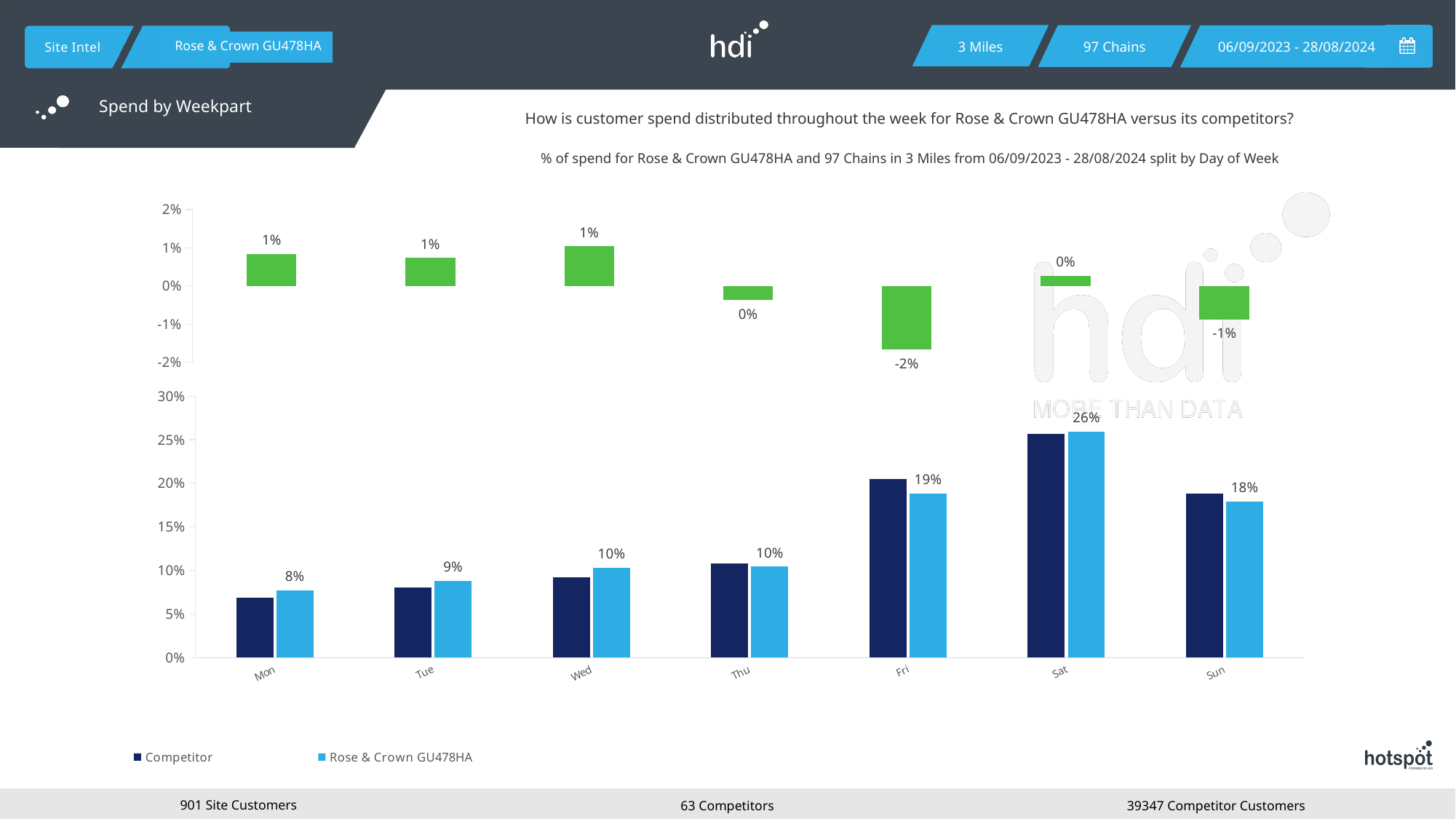
In the bottom bar chart, which day has the lowest Rose & Crown GU478HA value? Mon In the bottom bar chart, is the Competitor value for Mon greater or less than 10%? less How many days are shown on the x axis of the bottom bar chart? 7 In the bottom bar chart, which day has the highest Rose & Crown GU478HA value? Sat In the top chart with green bars, what is the value for Fri? -2% In the bottom bar chart, what is the difference between the Rose & Crown GU478HA values for Sat and Sun? 8% In the bottom bar chart, what is the value for Rose & Crown GU478HA on Fri? 19% In the top chart with green bars, which day has the lowest value? Fri In the bottom bar chart, is the Competitor value for Sat greater or less than 20%? greater In the bottom bar chart, what is the value for Rose & Crown GU478HA on Mon? 8% In the bottom bar chart, what is the value for Rose & Crown GU478HA on Sat? 26% How many series does the legend of the bottom bar chart list? 2